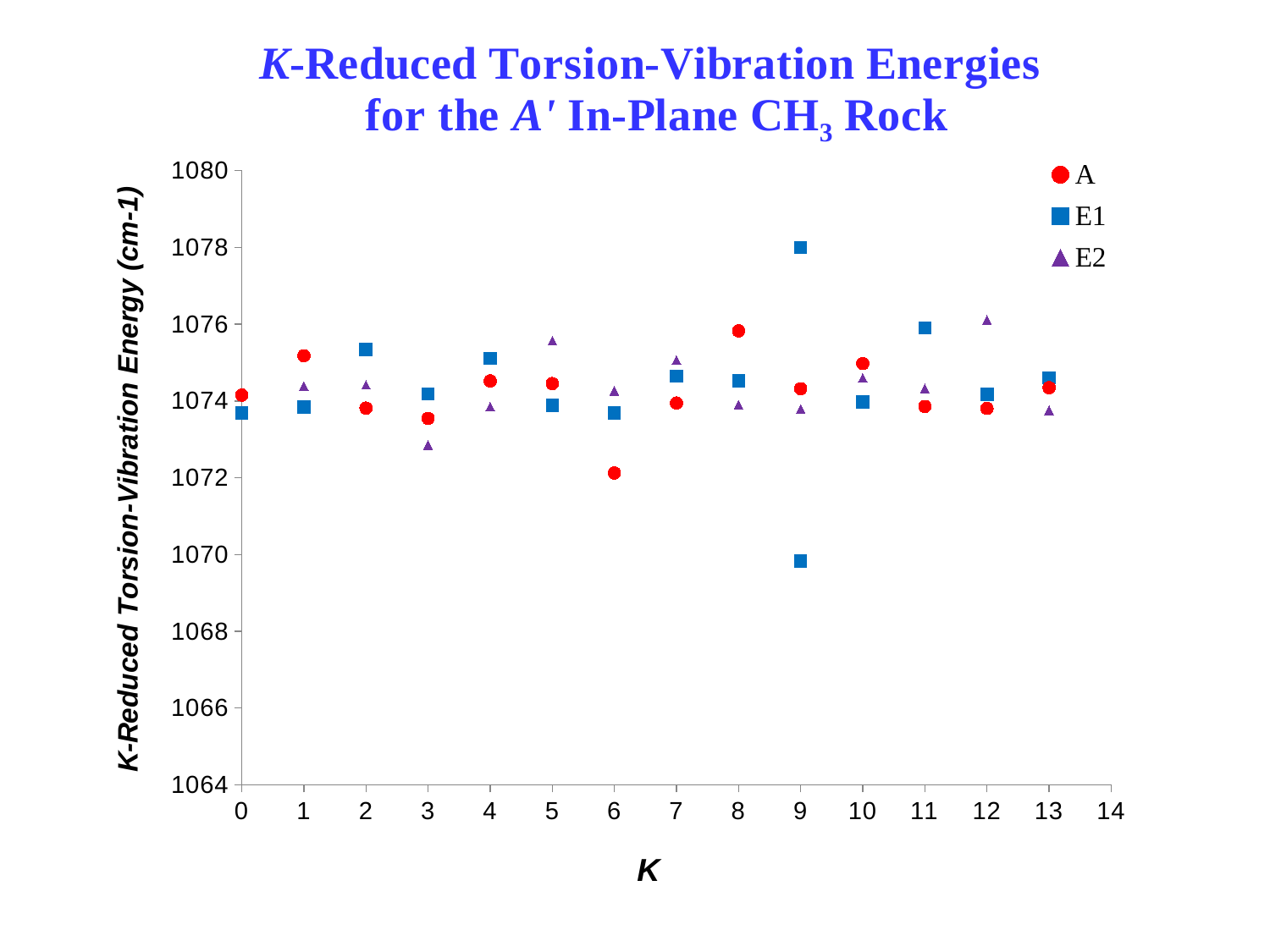
What kind of chart is shown on the slide? Scatter chart Is the value for series A at K = 8 greater or less than 1074? greater Which series contains the lowest plotted point on the chart? E1 At which value of K does the lowest plotted point occur? 9 At which value of K is the A series at its lowest? 6 Is the lower E1 value at K = 9 greater or less than 1070? less What is the label on the y axis? K-Reduced Torsion-Vibration Energy (cm-1) Is the value for series A at K = 6 greater or less than 1074? less At which value of K does the highest plotted point occur? 9 How many series does the legend list? 3 Which series has the highest plotted point on the chart? E1 Which is larger: the A value at K = 6 or the A value at K = 8? K = 8